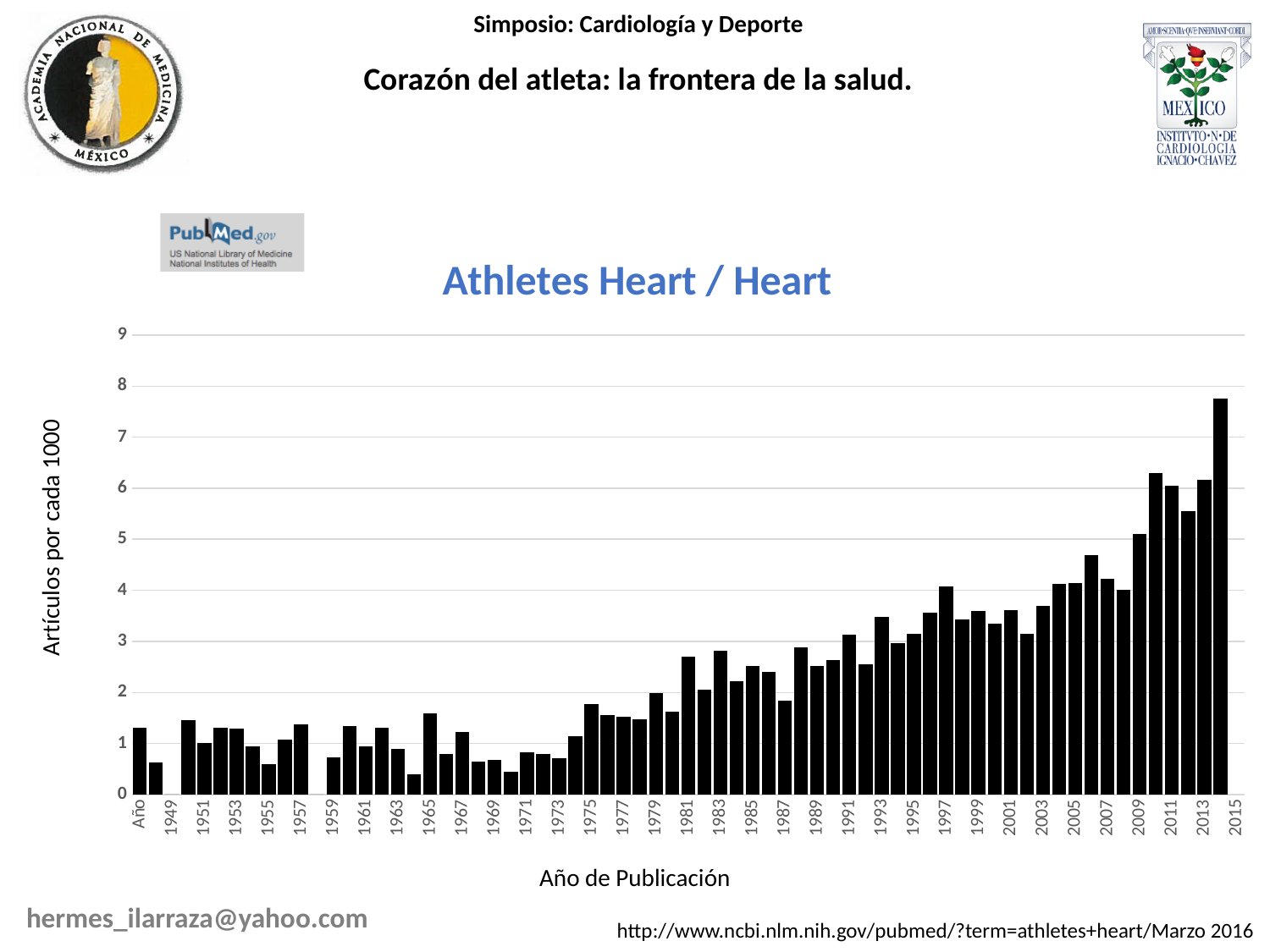
Which has the larger value, 1965 or 2009? 2009 Is the value for 1993 greater or less than 3? greater Overall, do the values rise or fall from the earliest years to the most recent years along the x axis? rise Which has the larger value, 1981 or 1999? 1999 Is the value for 1981 greater or less than 2? greater Is the value for the tallest (rightmost) bar greater or less than 7? greater What is the label of the vertical axis of the chart? Artículos por cada 1000 What kind of chart is shown on the slide? bar chart What is the title of the chart? Athletes Heart / Heart